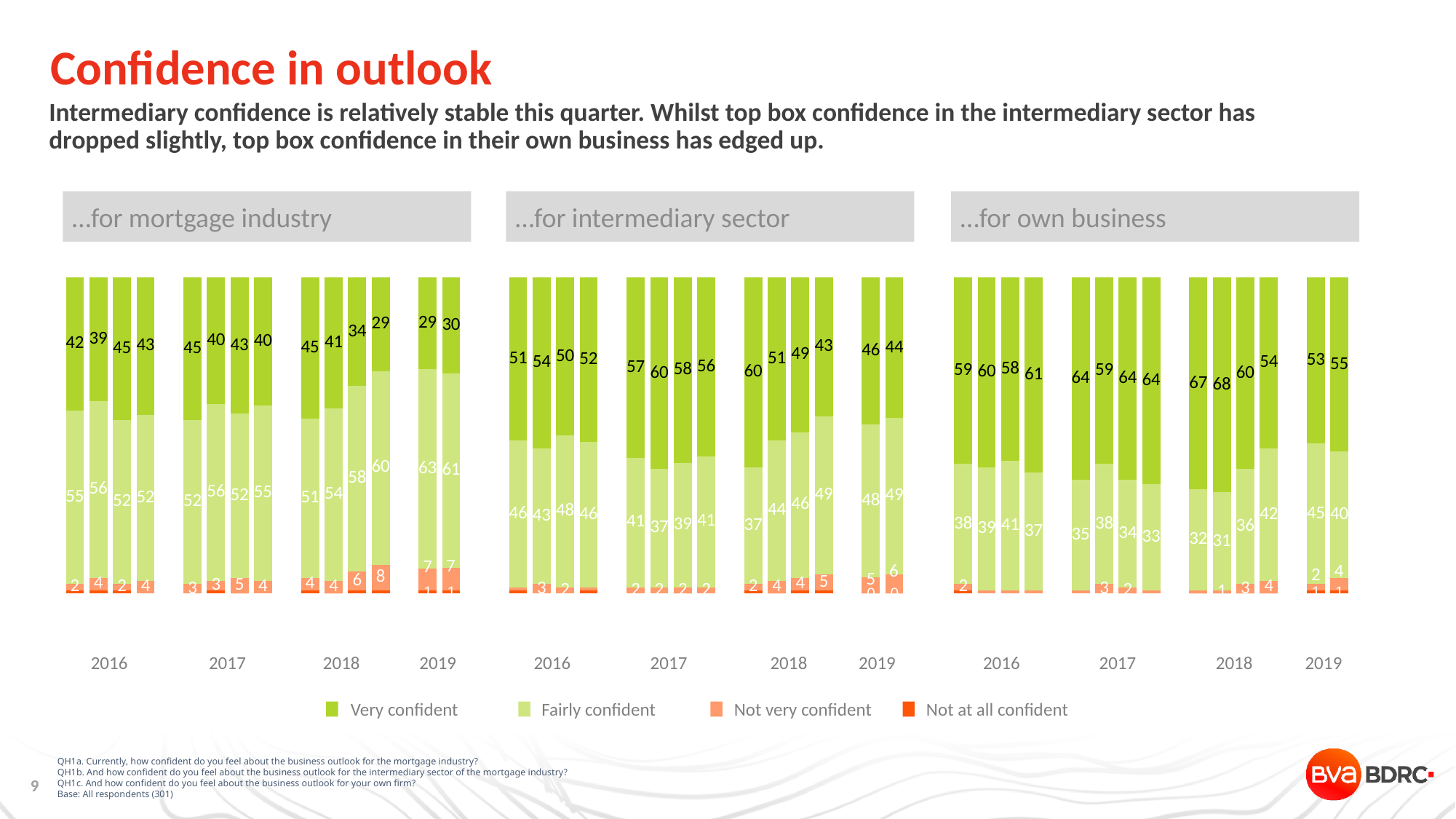
In the '...for own business' chart, what is the Very confident value for the last 2019 bar? 55 In the '...for intermediary sector' chart, what is the Not very confident value for the last 2019 bar? 6 In the '...for intermediary sector' chart, what is the difference between the Very confident value of the first 2018 bar (60) and the last 2019 bar (44)? 16 How many bars are plotted in the '...for intermediary sector' chart? 14 In the '...for mortgage industry' chart, for the first 2019 bar, which is larger: the Fairly confident value or the Very confident value? Fairly confident In the '...for mortgage industry' chart, do the Very confident values rise or fall across the four 2018 bars? Fall What kind of chart is used for the '...for mortgage industry' panel? Stacked bar chart In the '...for mortgage industry' chart, what is the lowest Very confident value shown? 29 In the '...for own business' chart, what is the highest Very confident value shown? 68 What is the title of the middle chart on the slide? ...for intermediary sector In the '...for own business' chart, what is the Fairly confident value for the first 2019 bar? 45 How many series does the legend list? 4